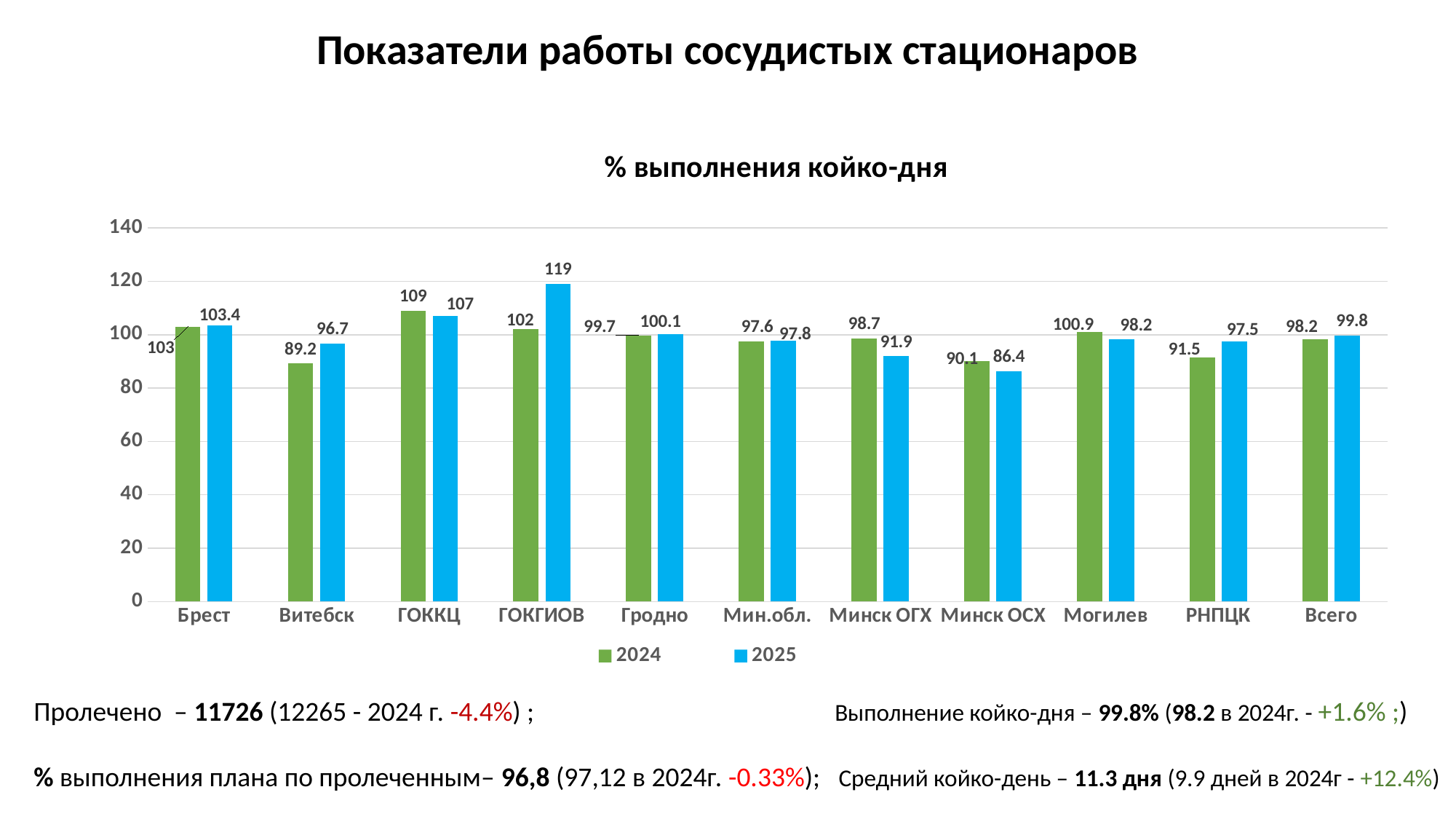
Which category has the lowest 2024 value? Витебск What is the 2024 value for Витебск? 89.2 How many series does the legend list? 2 How many categories are shown on the x axis? 11 Which category has the lowest 2025 value? Минск ОСХ What is the 2025 value for ГОКГИОВ? 119 What type of chart is shown? bar chart What is the difference between the 2025 and 2024 values for Витебск? 7.5 What is the 2025 value for Всего? 99.8 Which category has the highest 2025 value? ГОКГИОВ Is the 2024 value for ГОККЦ greater or less than 100? greater Which is larger for Минск ОГХ: the 2024 value or the 2025 value? 2024